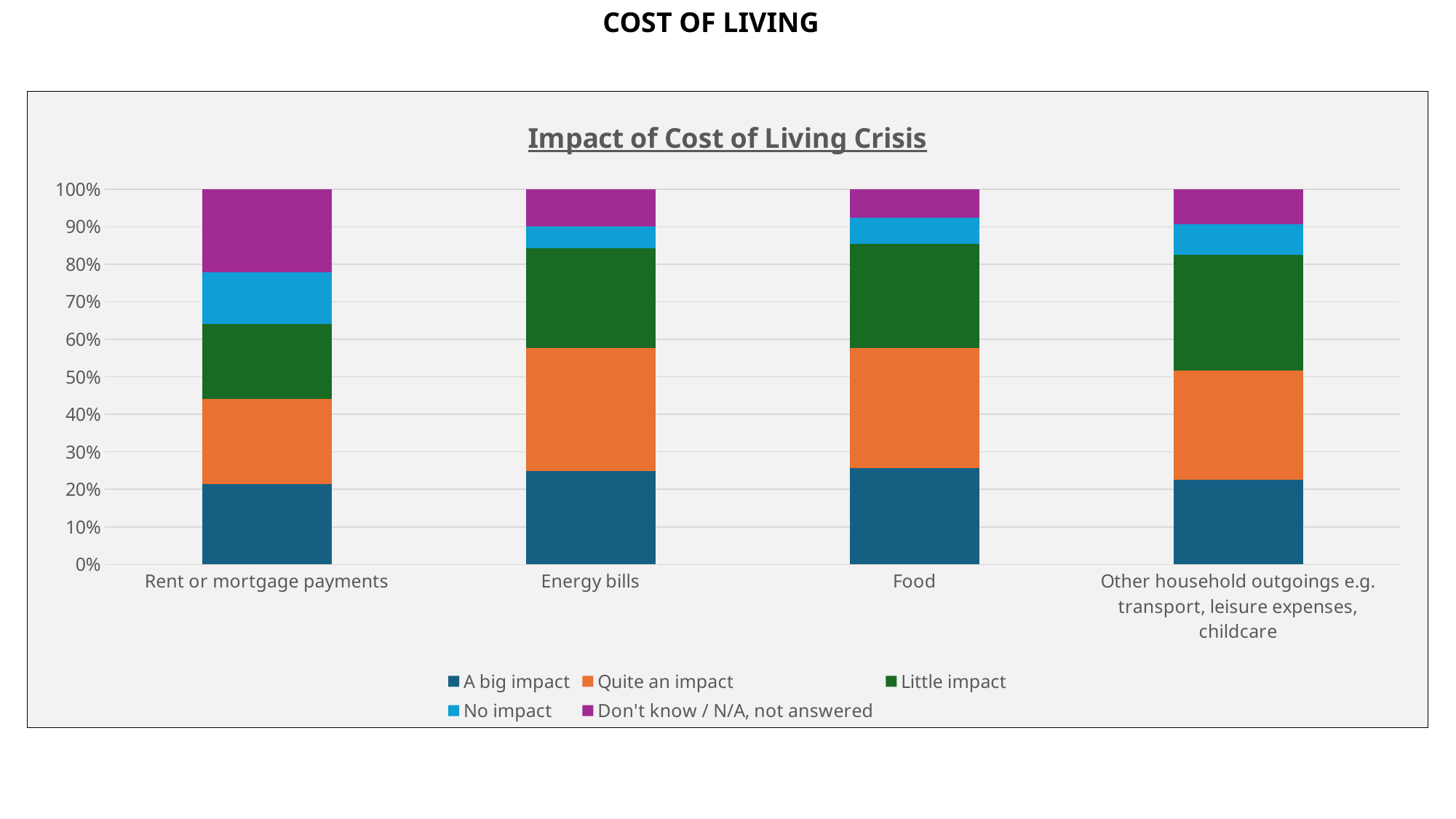
How many categories are shown on the x axis? 4 Which has the larger 'No impact' segment, Rent or mortgage payments or Food? Rent or mortgage payments Is the 'A big impact' value for Energy bills greater or less than 20%? greater Which category has the largest 'Don't know / N/A, not answered' segment? Rent or mortgage payments Which category has the largest 'No impact' segment? Rent or mortgage payments How many series does the legend list? 5 What is the title of the chart? Impact of Cost of Living Crisis What is the total height of the stacked bar for Food? 100% What kind of chart is shown on the slide? Stacked bar chart Which series is shown in purple in the legend? Don't know / N/A, not answered Which has the larger 'Quite an impact' segment, Energy bills or Rent or mortgage payments? Energy bills Is the 'A big impact' value for Rent or mortgage payments greater or less than 30%? less